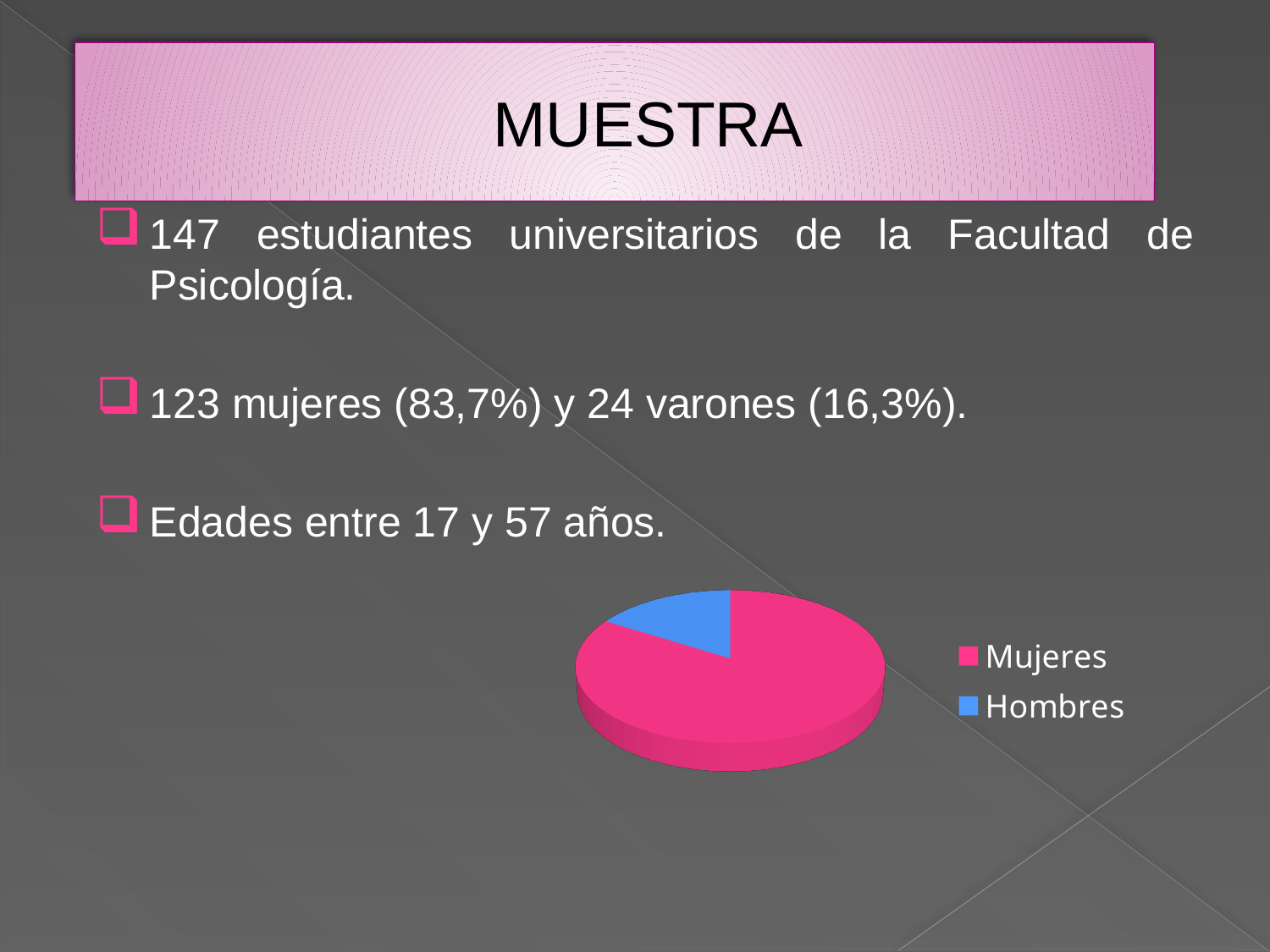
How many entries does the legend of the pie chart list? 2 What kind of chart is shown on the slide? pie chart Which category has the largest slice in the pie chart? Mujeres Which slice is larger in the pie chart, Mujeres or Hombres? Mujeres What colour is the Hombres slice in the pie chart? blue What colour is the Mujeres slice in the pie chart? pink Does the Mujeres slice take up more or less than half of the pie chart? more How many slices does the pie chart have? 2 Which category has the smallest slice in the pie chart? Hombres